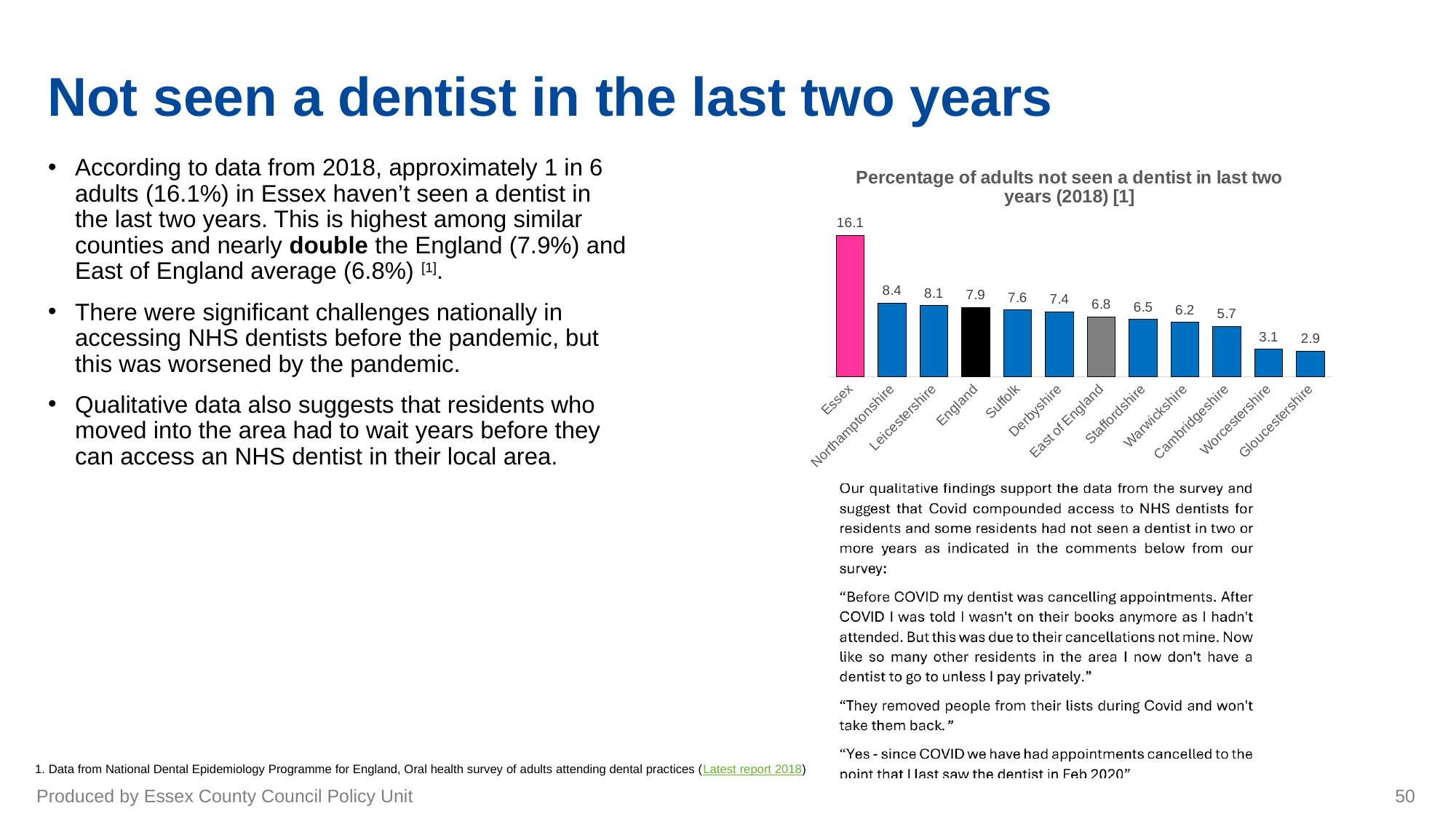
What is the title of the chart? Percentage of adults not seen a dentist in last two years (2018) [1] What is the value for Suffolk in the chart? 7.6 Which has a larger value, Derbyshire or Staffordshire? Derbyshire What is the difference between the values for Essex and England? 8.2 What is the value for Essex in the chart? 16.1 What is the value for East of England in the chart? 6.8 Which category has the highest value in the chart? Essex What is the difference between the values for Northamptonshire and Cambridgeshire? 2.7 Which category has the lowest value in the chart? Gloucestershire Which has a larger value, Worcestershire or Warwickshire? Warwickshire What kind of chart is shown on the slide? Bar chart How many categories are shown in the chart? 12